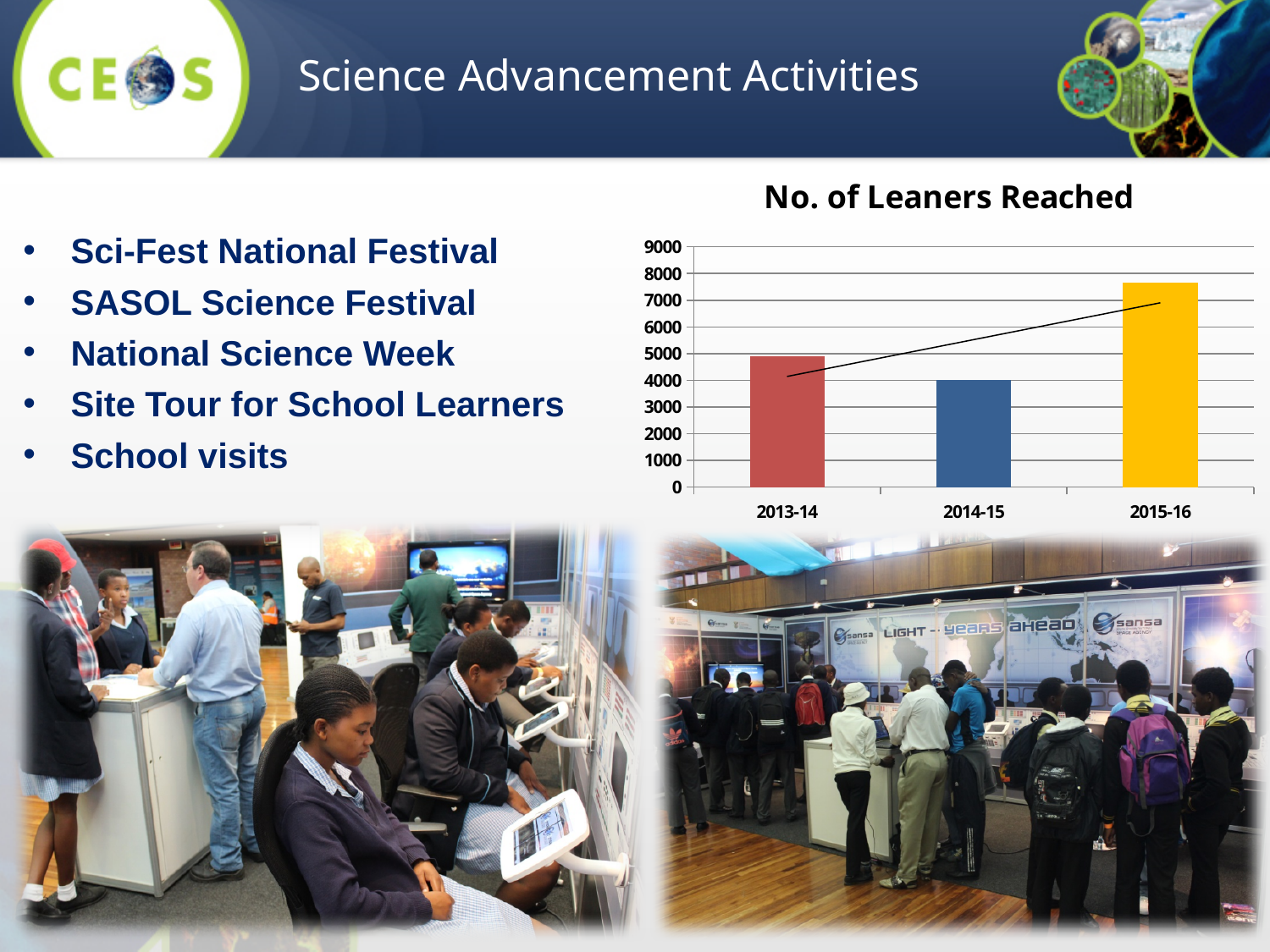
How many categories are shown on the x axis of the chart? 3 Is the value for 2015-16 greater or less than 7000? greater What is the title of the chart? No. of Leaners Reached Which year has the lowest number of learners reached? 2014-15 Which year has the highest number of learners reached? 2015-16 What kind of chart is shown on the slide? bar chart Is the value for 2014-15 greater or less than 5000? less Is the value for 2013-14 greater or less than 6000? less Which is larger, the value for 2013-14 or the value for 2014-15? 2013-14 Does the value rise or fall from 2014-15 to 2015-16? rise What colour is the bar for 2015-16? yellow